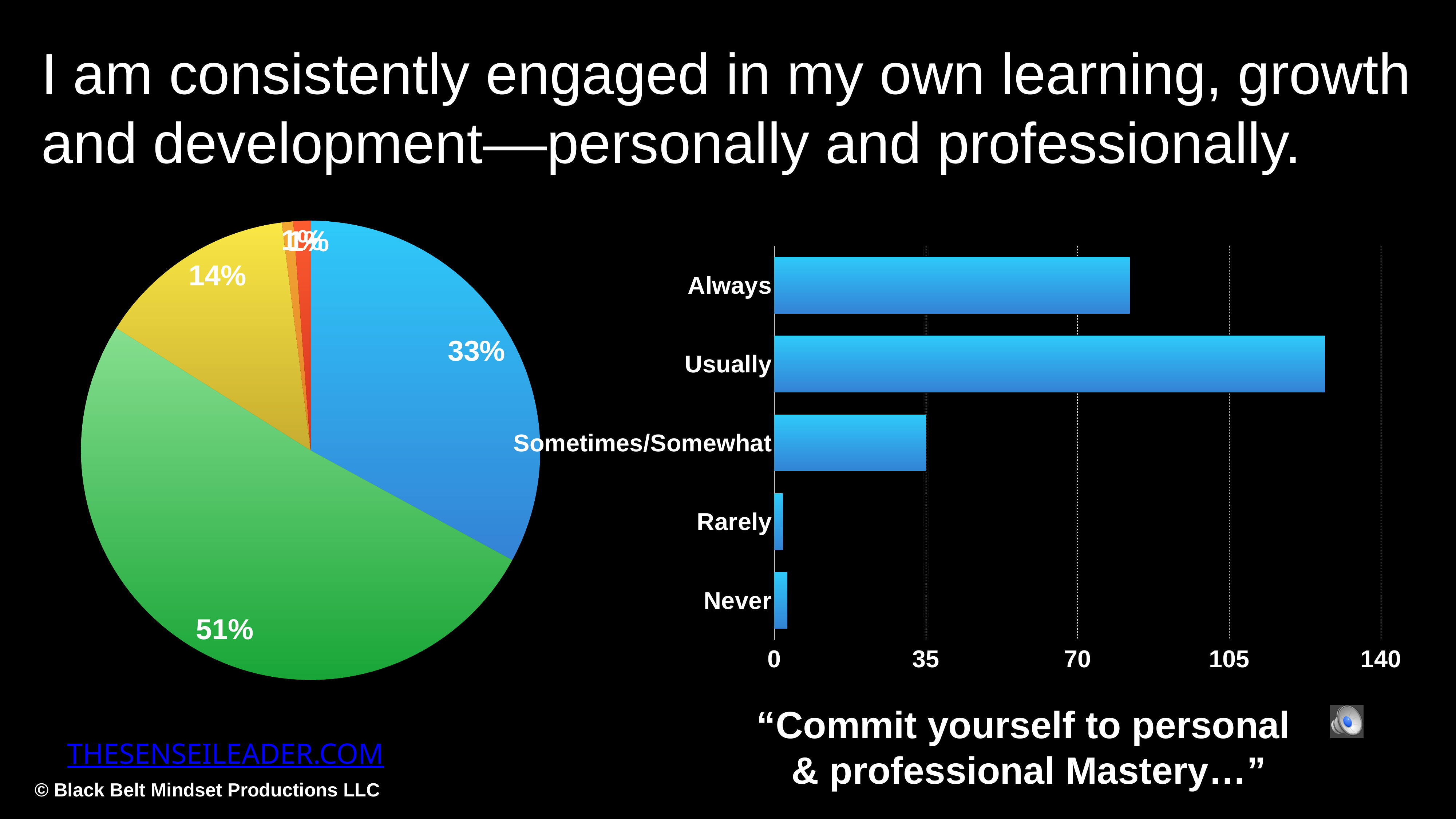
What kind of chart is on the right side of the slide? bar chart In the pie chart on the left, what is the difference in percentage points between the green slice and the blue slice? 18 In the bar chart on the right, is the value for Usually greater or less than 105? greater In the bar chart on the right, which is larger, the value for Always or the value for Usually? Usually In the pie chart on the left, what share does the blue slice have? 33% In the pie chart on the left, what share does the largest slice have? 51% In the bar chart on the right, how many categories are shown? 5 In the pie chart on the left, what share does the yellow slice have? 14% What kind of chart is on the left side of the slide? pie chart In the bar chart on the right, is the value for Always greater or less than 70? greater In the bar chart on the right, is the value for Rarely greater or less than 35? less In the bar chart on the right, which category has the highest value? Usually